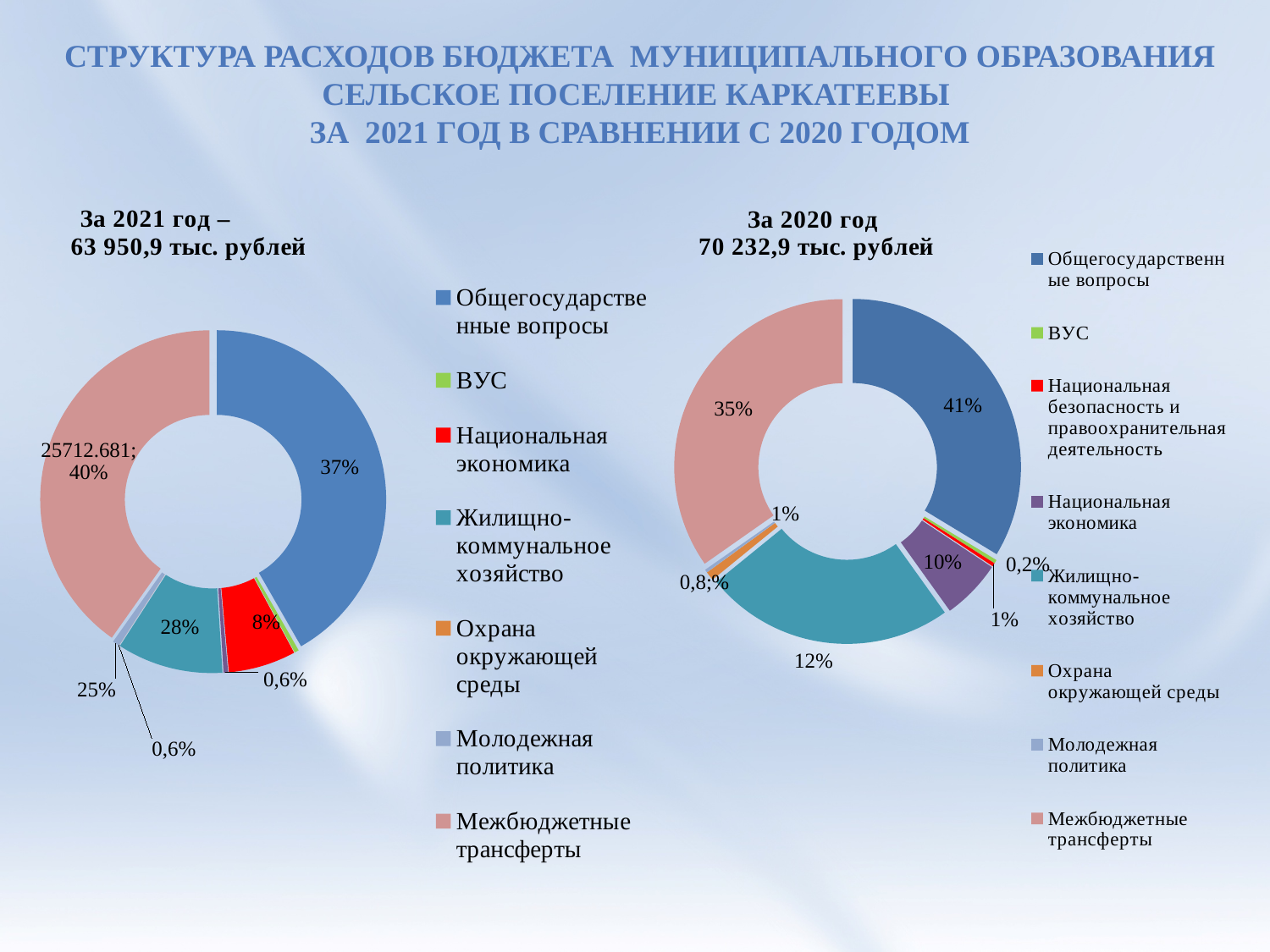
In the chart 'За 2020 год', which category has the largest share? Общегосударственные вопросы In the chart 'За 2020 год', which is larger: Жилищно-коммунальное хозяйство or Национальная экономика? Жилищно-коммунальное хозяйство In the chart 'За 2021 год', what share is shown for Общегосударственные вопросы? 37% In the chart 'За 2021 год', what share is shown for Жилищно-коммунальное хозяйство? 28% In the chart 'За 2020 год', what share is shown for Общегосударственные вопросы? 41% In the chart 'За 2020 год', what share is shown for Межбюджетные трансферты? 35% In the chart 'За 2020 год', by how many percentage points does Общегосударственные вопросы exceed Межбюджетные трансферты? 6 percentage points In the chart 'За 2020 год', what share is shown for Национальная экономика? 10% How many categories does the legend of the chart 'За 2020 год' list? 8 What kind of chart is used on this slide for the 2021 and 2020 budget structures? doughnut (pie) chart In the chart 'За 2020 год', what share is shown for Жилищно-коммунальное хозяйство? 12% In the chart 'За 2021 год', what share is shown for Национальная экономика? 8%